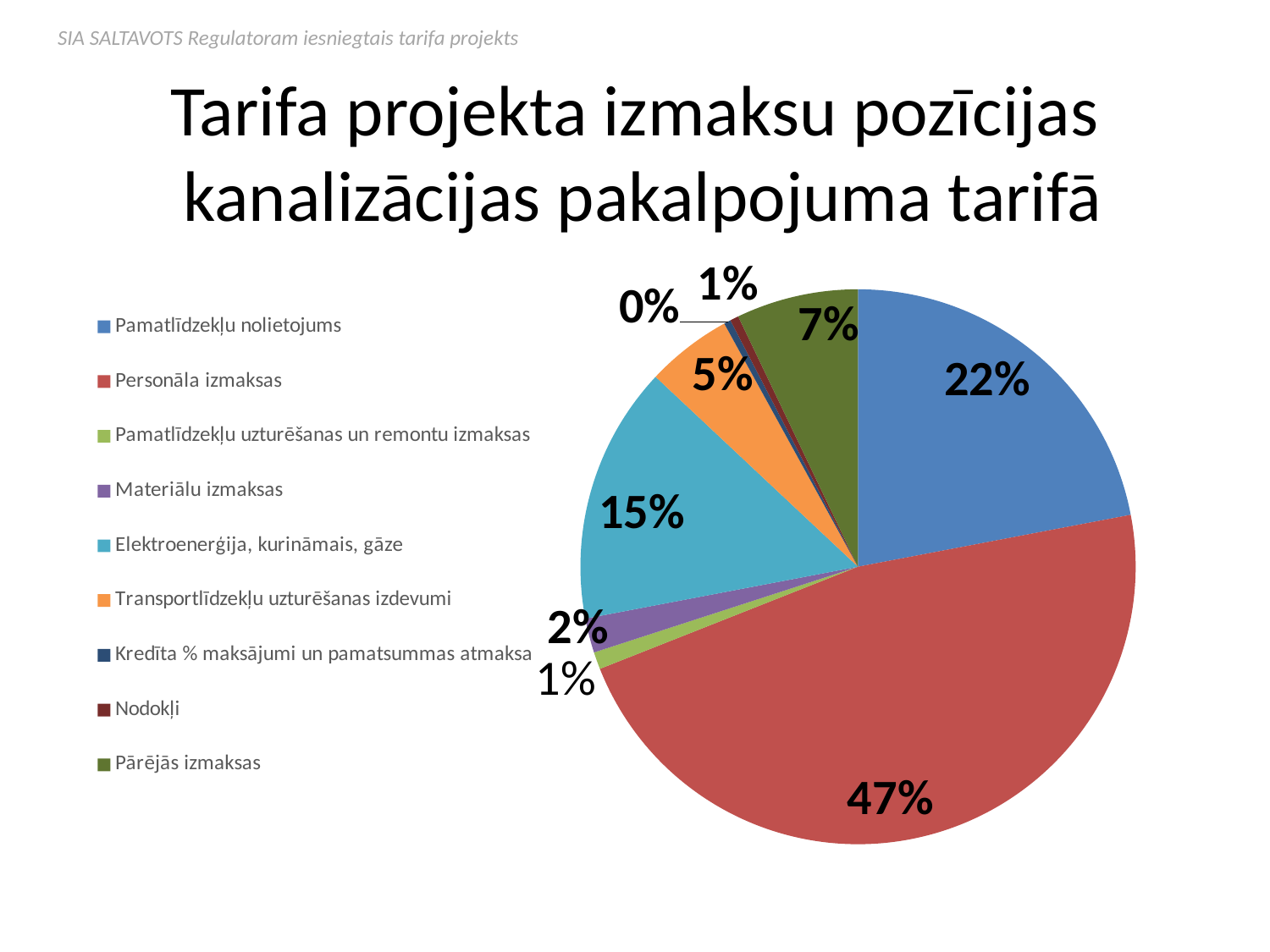
What share of the pie does Pārējās izmaksas represent? 7% How many categories does the legend list? 9 What kind of chart is shown on the slide? Pie chart What share of the pie does Personāla izmaksas represent? 47% Which category has the largest share of the pie? Personāla izmaksas What share of the pie does Transportlīdzekļu uzturēšanas izdevumi represent? 5% Which category has the smallest share of the pie? Kredīta % maksājumi un pamatsummas atmaksa What is the difference in percentage points between Personāla izmaksas and Pamatlīdzekļu nolietojums? 25 Which is larger, Elektroenerģija, kurināmais, gāze or Pārējās izmaksas? Elektroenerģija, kurināmais, gāze